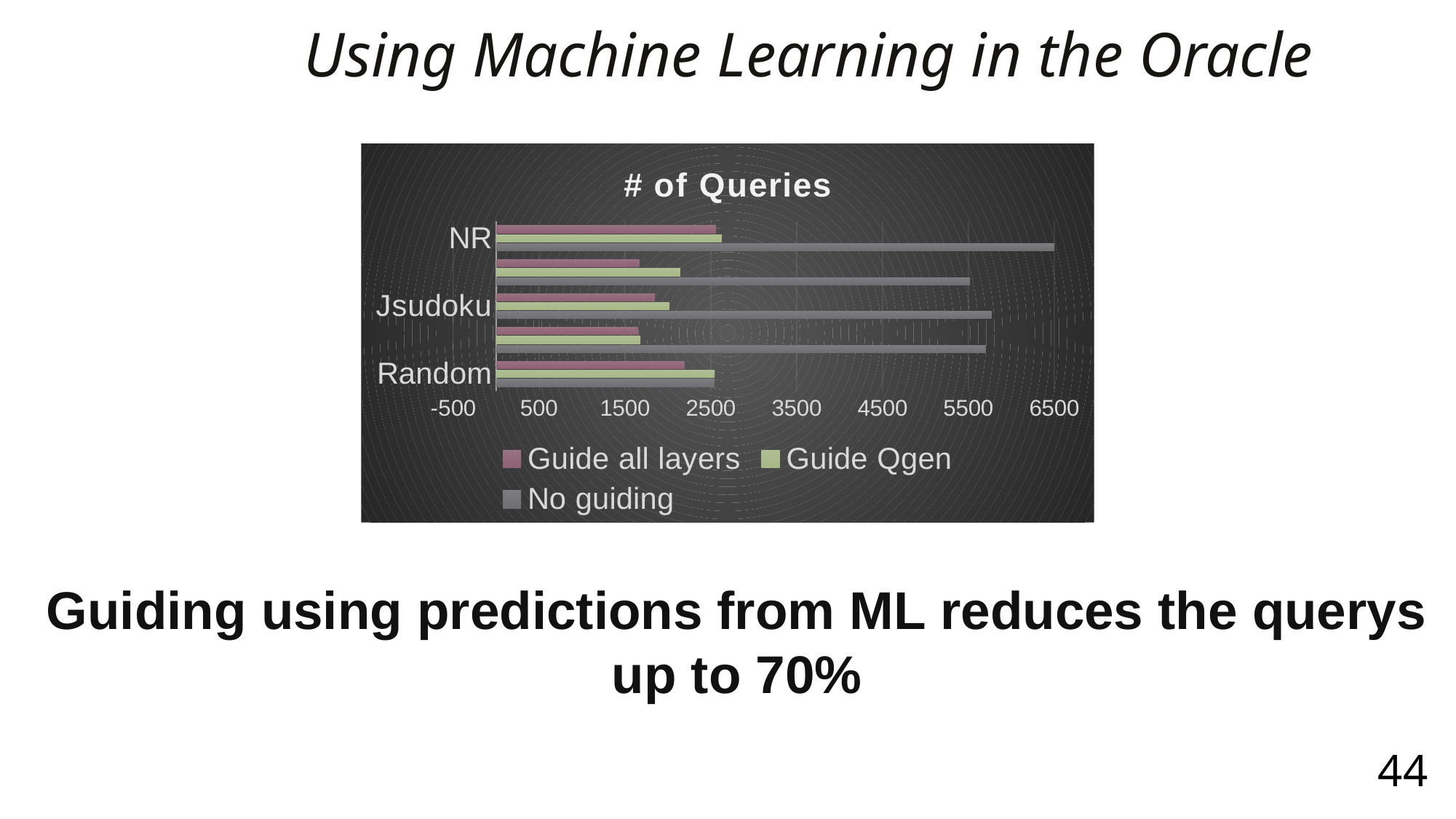
Is the Guide all layers value for NR greater or less than 3500? less Which series are listed in the chart's legend? Guide all layers, Guide Qgen, No guiding Is the Guide Qgen value for Random greater or less than 1500? greater Is the No guiding value for NR greater or less than 5500? greater For NR, which series has the highest value? No guiding For NR, which is larger: the No guiding value or the Guide Qgen value? No guiding For Random, which of the two plotted series, Guide all layers or Guide Qgen, has the lower value? Guide all layers How many series does the legend of the chart list? 3 What kind of chart is shown on the slide? bar chart What is the title of the chart? # of Queries